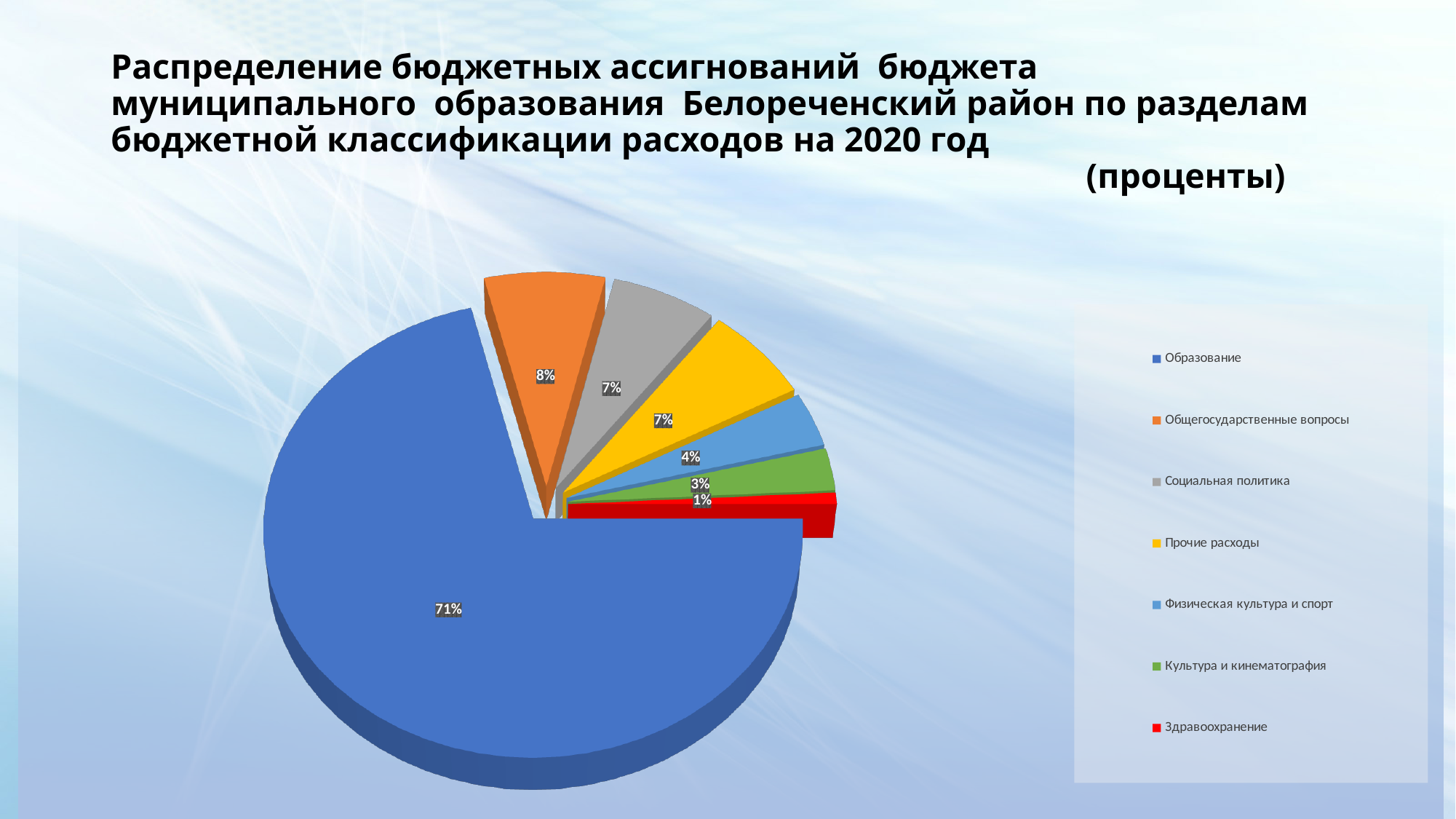
What colour is the slice for Здравоохранение? Red Which category has the largest share of the pie? Образование Which is larger, the share for Физическая культура и спорт or the share for Культура и кинематография? Физическая культура и спорт What is the difference in percentage points between Образование and Общегосударственные вопросы? 63 How many categories does the pie chart show? 7 What share of the budget goes to Культура и кинематография? 3% Which category has the smallest share of the pie? Здравоохранение What share of the budget goes to Образование? 71% What share of the budget goes to Физическая культура и спорт? 4% What kind of chart is shown on the slide? Pie chart What share of the budget goes to Общегосударственные вопросы? 8% What share of the budget goes to Здравоохранение? 1%